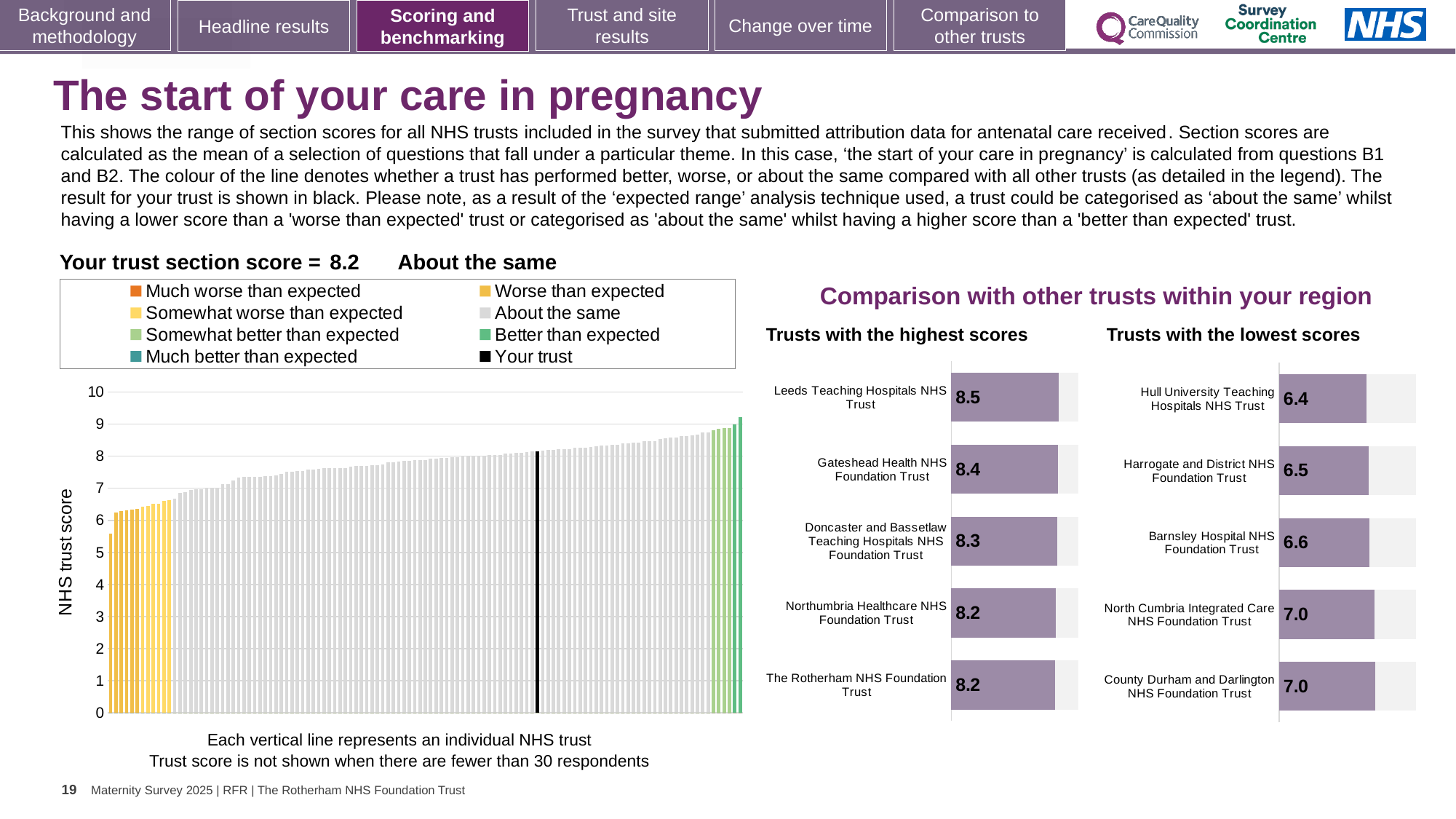
In the 'Trusts with the highest scores' chart, what is the difference between the scores of Leeds Teaching Hospitals NHS Trust and The Rotherham NHS Foundation Trust? 0.3 In the 'Trusts with the lowest scores' chart, which has the larger score: Barnsley Hospital NHS Foundation Trust or Harrogate and District NHS Foundation Trust? Barnsley Hospital NHS Foundation Trust What is your trust's section score shown above the 'NHS trust score' chart? 8.2 What kind of chart is the 'NHS trust score' chart on the left of the slide? bar chart In the 'Trusts with the lowest scores' chart, what is the score for Hull University Teaching Hospitals NHS Trust? 6.4 In the 'NHS trust score' chart, do the values rise or fall from left to right along the x axis? rise In the 'Trusts with the highest scores' chart, which trust has the highest score? Leeds Teaching Hospitals NHS Trust How many trusts are shown in the 'Trusts with the highest scores' chart? 5 In the 'Trusts with the lowest scores' chart, which trust has the lowest score? Hull University Teaching Hospitals NHS Trust In the 'Trusts with the highest scores' chart, what is the score for Leeds Teaching Hospitals NHS Trust? 8.5 How many entries does the legend above the 'NHS trust score' chart list? 8 In the 'Trusts with the lowest scores' chart, what is the difference between the scores of County Durham and Darlington NHS Foundation Trust and Hull University Teaching Hospitals NHS Trust? 0.6